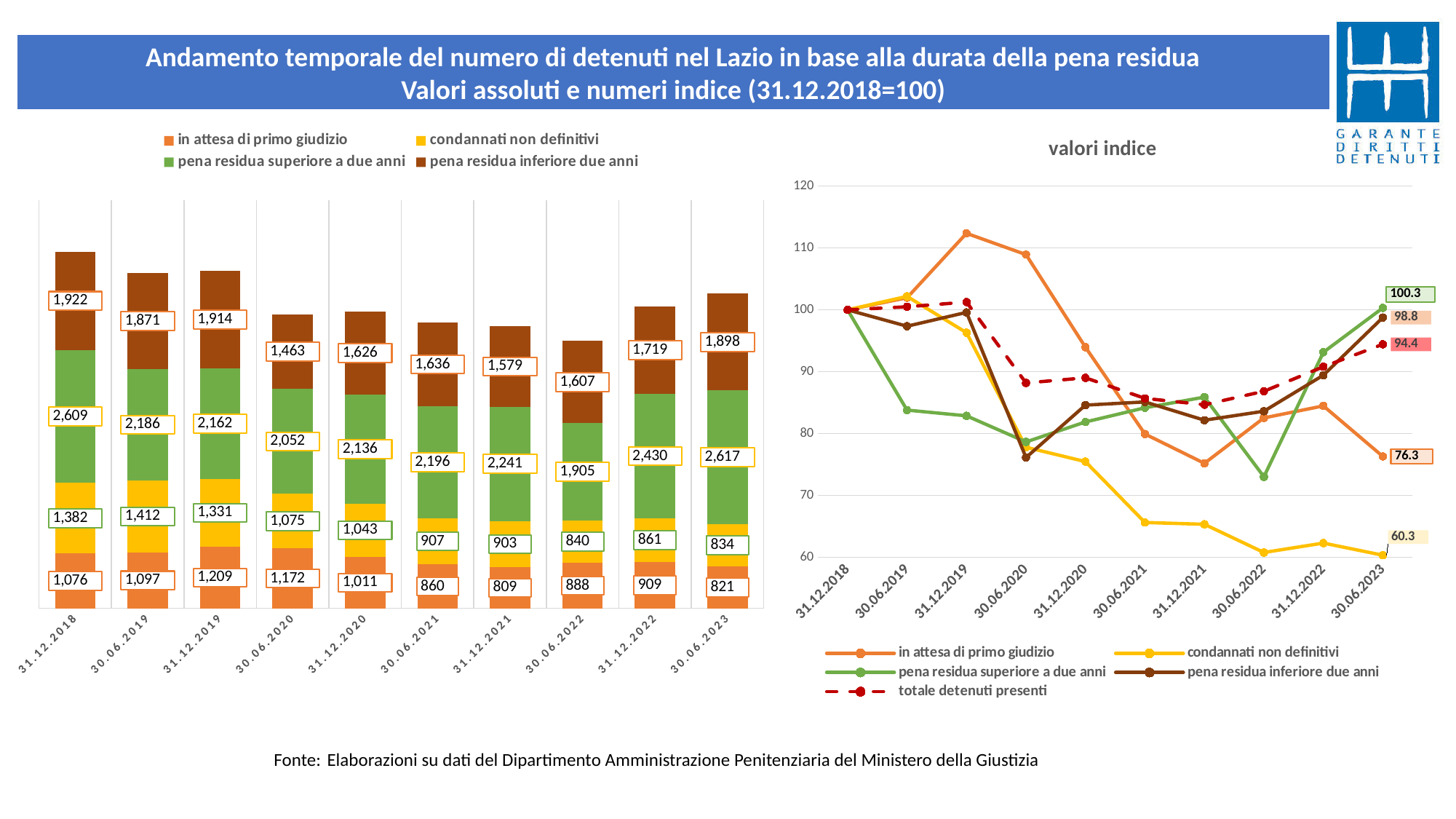
In the left-hand bar chart, what is the value for 'pena residua superiore a due anni' at 30.06.2023? 2,617 How many series does the legend of the left-hand bar chart list? 4 What kind of chart is the left-hand chart on the slide? Stacked bar chart How many series does the legend of the 'valori indice' chart list? 5 In the 'valori indice' chart, what is the index value for 'condannati non definitivi' at 30.06.2023? 60.3 In the 'valori indice' chart, is the value for 'in attesa di primo giudizio' at 31.12.2019 greater or less than 110? greater In the left-hand bar chart, which date has the larger value for 'condannati non definitivi': 30.06.2019 or 31.12.2019? 30.06.2019 In the left-hand bar chart, what is the value for 'in attesa di primo giudizio' at 31.12.2018? 1,076 How many dates are shown on the x axis of the left-hand bar chart? 10 In the left-hand bar chart, what is the difference between the 'pena residua inferiore due anni' values at 31.12.2018 and 30.06.2020? 459 In the left-hand bar chart, at which date is the value for 'in attesa di primo giudizio' lowest? 31.12.2021 What kind of chart is the 'valori indice' chart on the right? Line chart